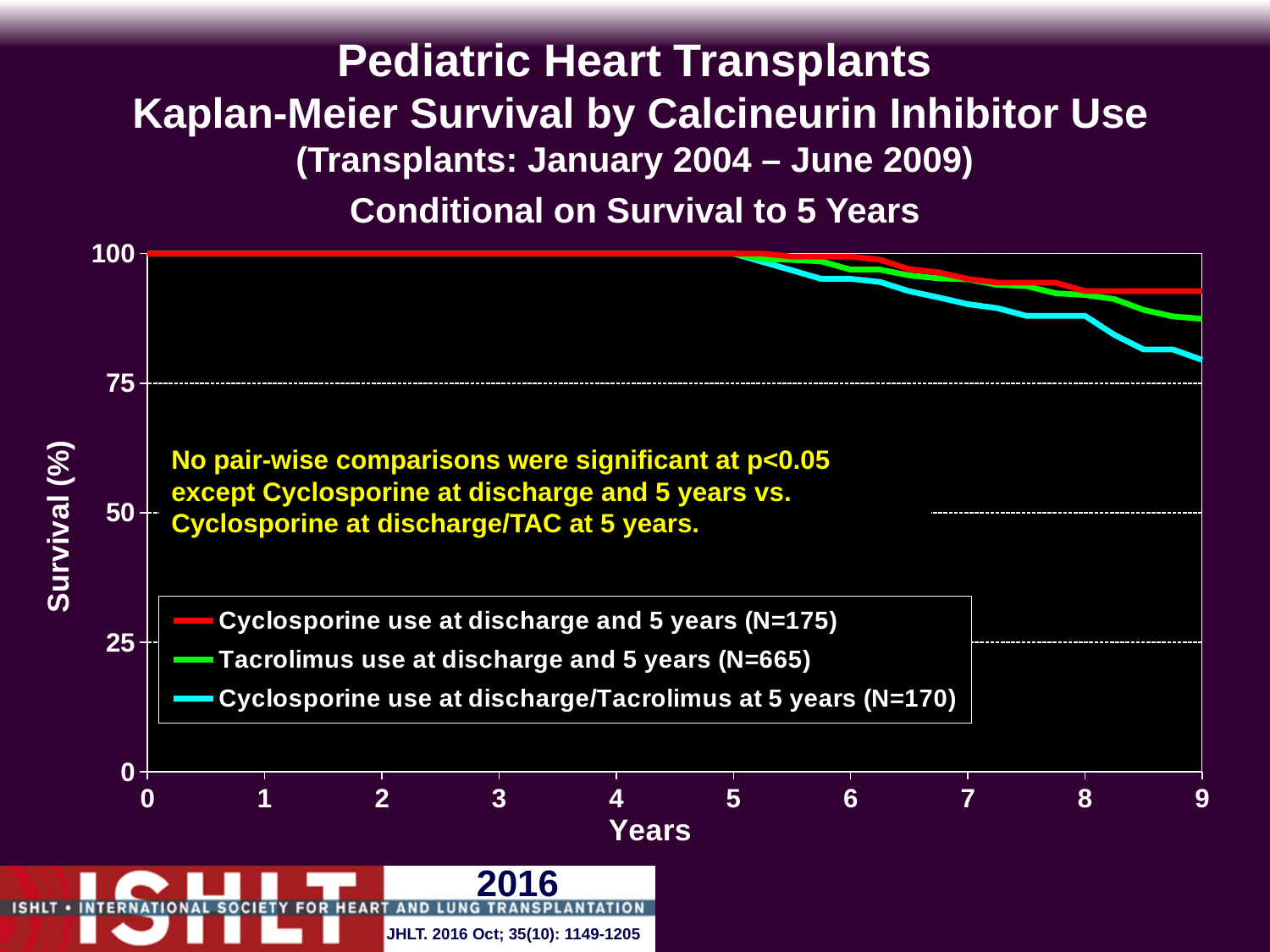
How many series does the legend list? 3 Is the survival for Cyclosporine use at discharge/Tacrolimus at 5 years at 9 years greater or less than 75? greater What is the label of the x axis? Years Is the survival for Tacrolimus use at discharge and 5 years at 9 years greater or less than 75? greater Which series has the highest survival at 9 years? Cyclosporine use at discharge and 5 years (N=175) Which series has the lowest survival at 9 years? Cyclosporine use at discharge/Tacrolimus at 5 years (N=170) What is the label of the y axis? Survival (%) At 9 years, is survival higher for Cyclosporine use at discharge and 5 years or for Cyclosporine use at discharge/Tacrolimus at 5 years? Cyclosporine use at discharge and 5 years Is the survival for Cyclosporine use at discharge and 5 years at 7 years greater or less than 75? greater Do the survival curves rise or fall after 5 years? Fall What kind of chart is shown on the slide? Line chart How many tick marks are labelled on the x axis? 10